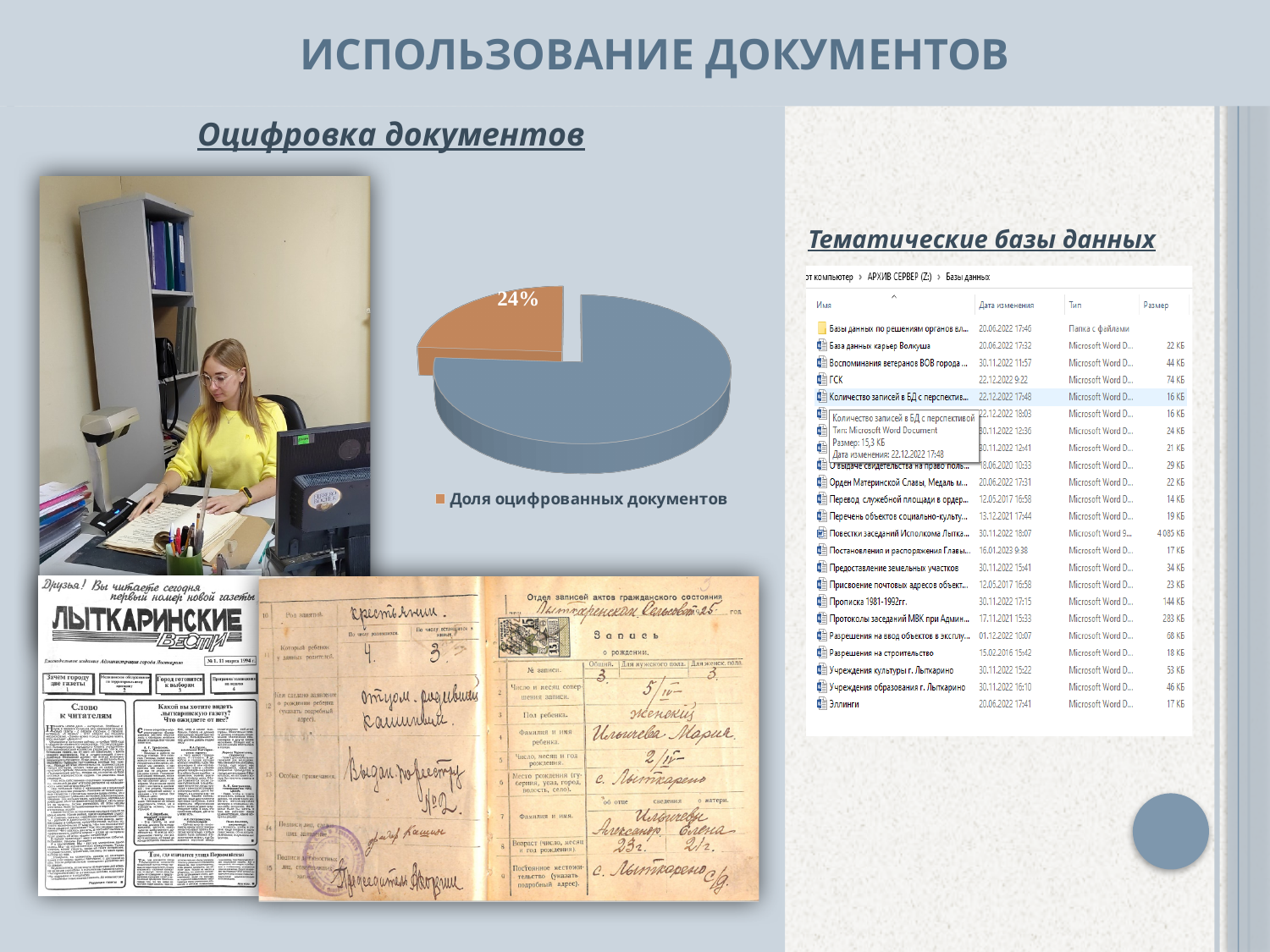
How many slices does the pie chart have? 2 Which slice of the pie chart is larger, the orange slice labelled 24% or the blue slice? the blue slice What is the legend entry shown below the pie chart? Доля оцифрованных документов What kind of chart is shown on the slide? pie chart What share of the pie does the orange slice represent? 24% What colour is the slice labelled 24% in the pie chart? orange How many entries does the legend of the pie chart list? 1 What percentage is printed on the labelled slice of the pie chart? 24%